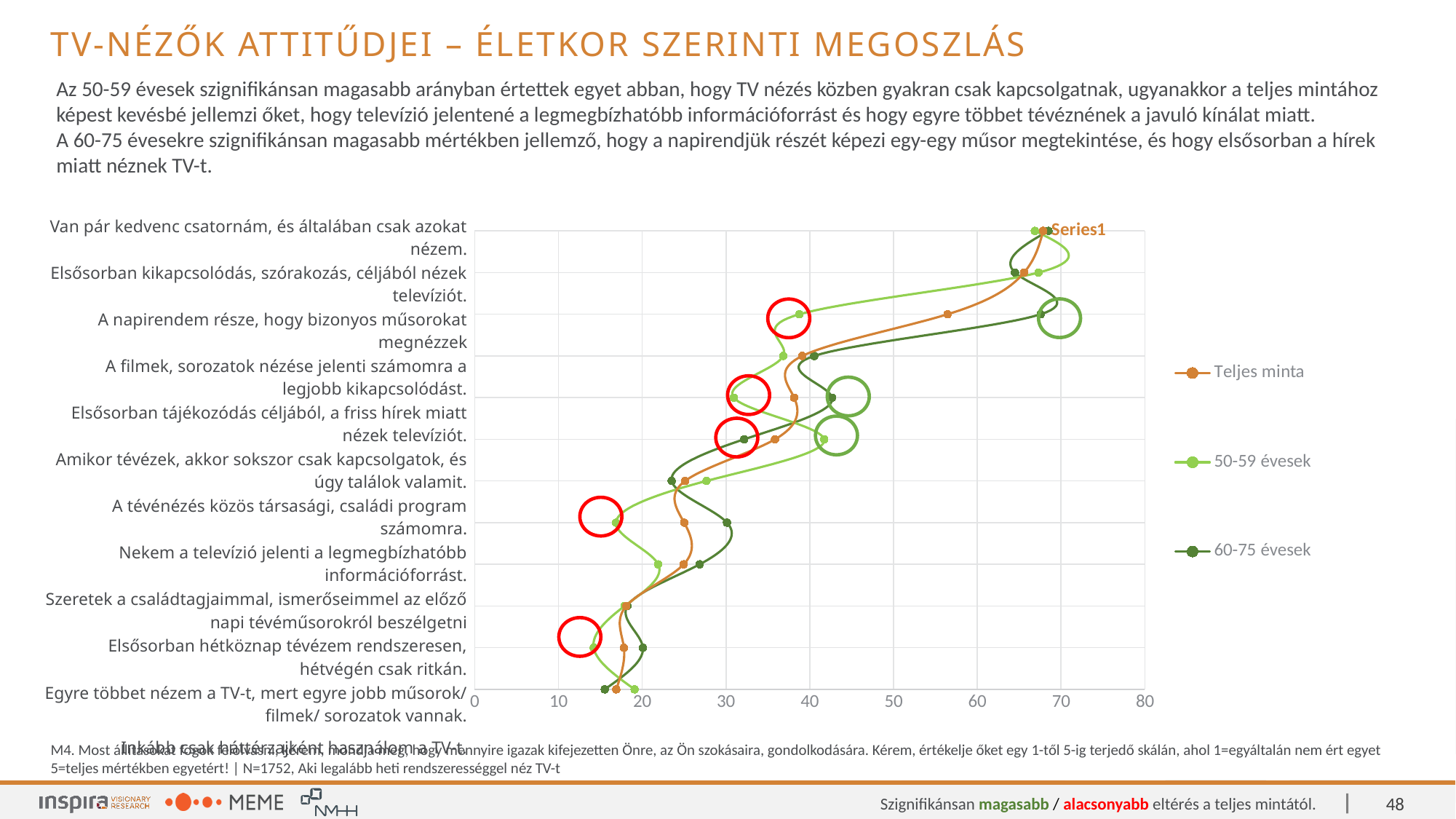
For 'A napirendem része, hogy bizonyos műsorokat megnézzek', which series has the larger value: 50-59 évesek or 60-75 évesek? 60-75 évesek How many statements (categories) are plotted on the chart? 12 Which series are listed in the chart legend? Teljes minta, 50-59 évesek, 60-75 évesek What kind of chart is shown on the slide? line chart For which statement does the Teljes minta series reach its highest value? Van pár kedvenc csatornám, és általában csak azokat nézem. For 'Elsősorban tájékozódás céljából, a friss hírek miatt nézek televíziót.', which series has the larger value: 50-59 évesek or 60-75 évesek? 60-75 évesek What is the highest value shown on the horizontal axis of the chart? 80 Is the 60-75 évesek value for 'A napirendem része, hogy bizonyos műsorokat megnézzek' greater or less than 60? greater Is the Teljes minta value for 'Van pár kedvenc csatornám, és általában csak azokat nézem.' greater or less than 60? greater Is the 50-59 évesek value for 'A tévénézés közös társasági, családi program számomra.' greater or less than 20? greater How many series does the chart legend list? 3